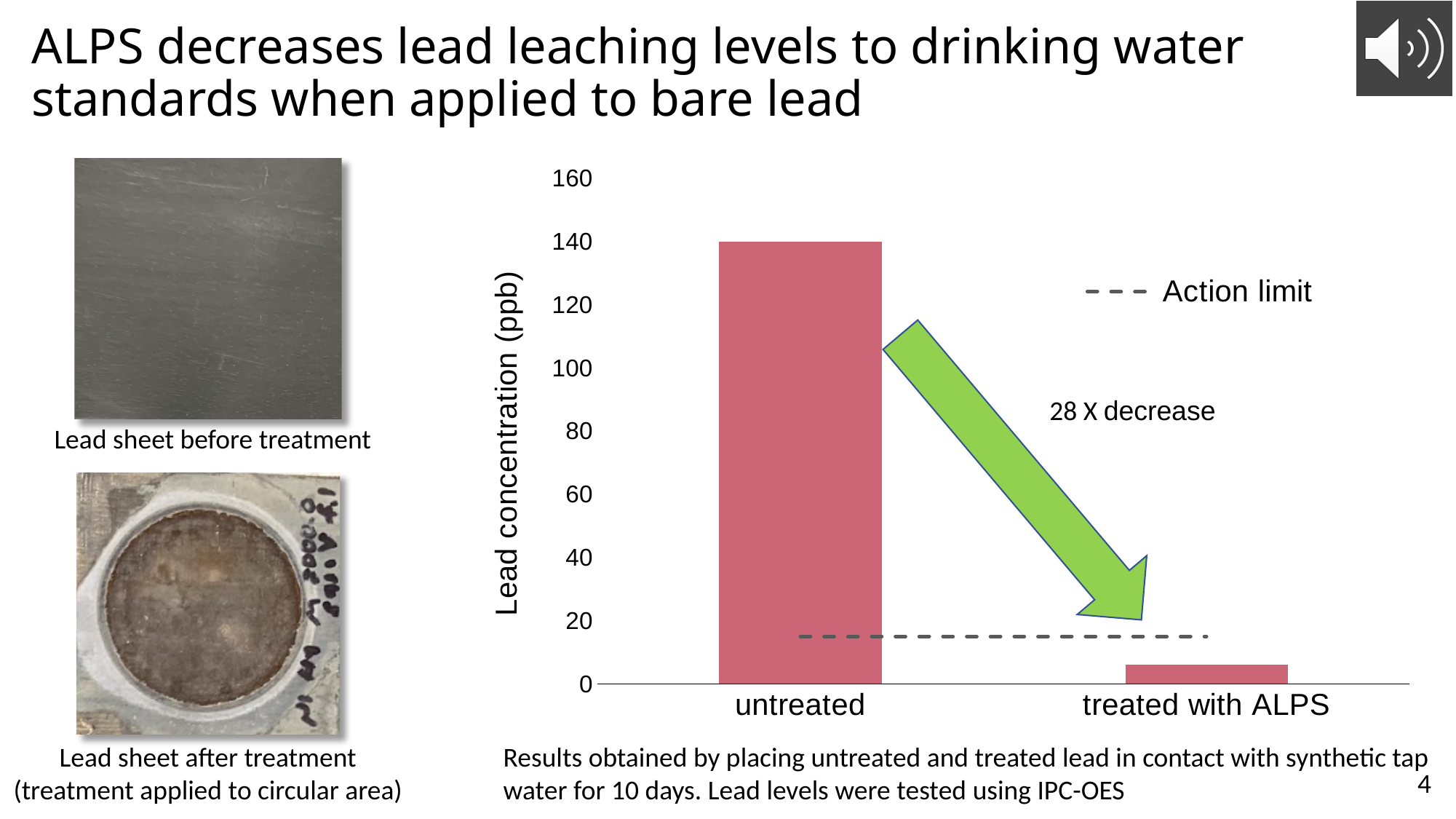
Do the values rise or fall from untreated to treated with ALPS along the x axis? fall Which has a larger lead concentration, untreated or treated with ALPS? untreated Is the lead concentration for untreated greater or less than 100? greater How many categories are shown on the x axis of the chart? 2 Is the lead concentration for untreated greater or less than 120? greater Is the lead concentration for treated with ALPS greater or less than 40? less What kind of chart is shown on the slide? bar chart Which category has the lowest lead concentration in the chart? treated with ALPS What is the label of the y axis of the chart? Lead concentration (ppb) What does the dashed line in the chart represent, according to the legend? Action limit Which category has the highest lead concentration in the chart? untreated